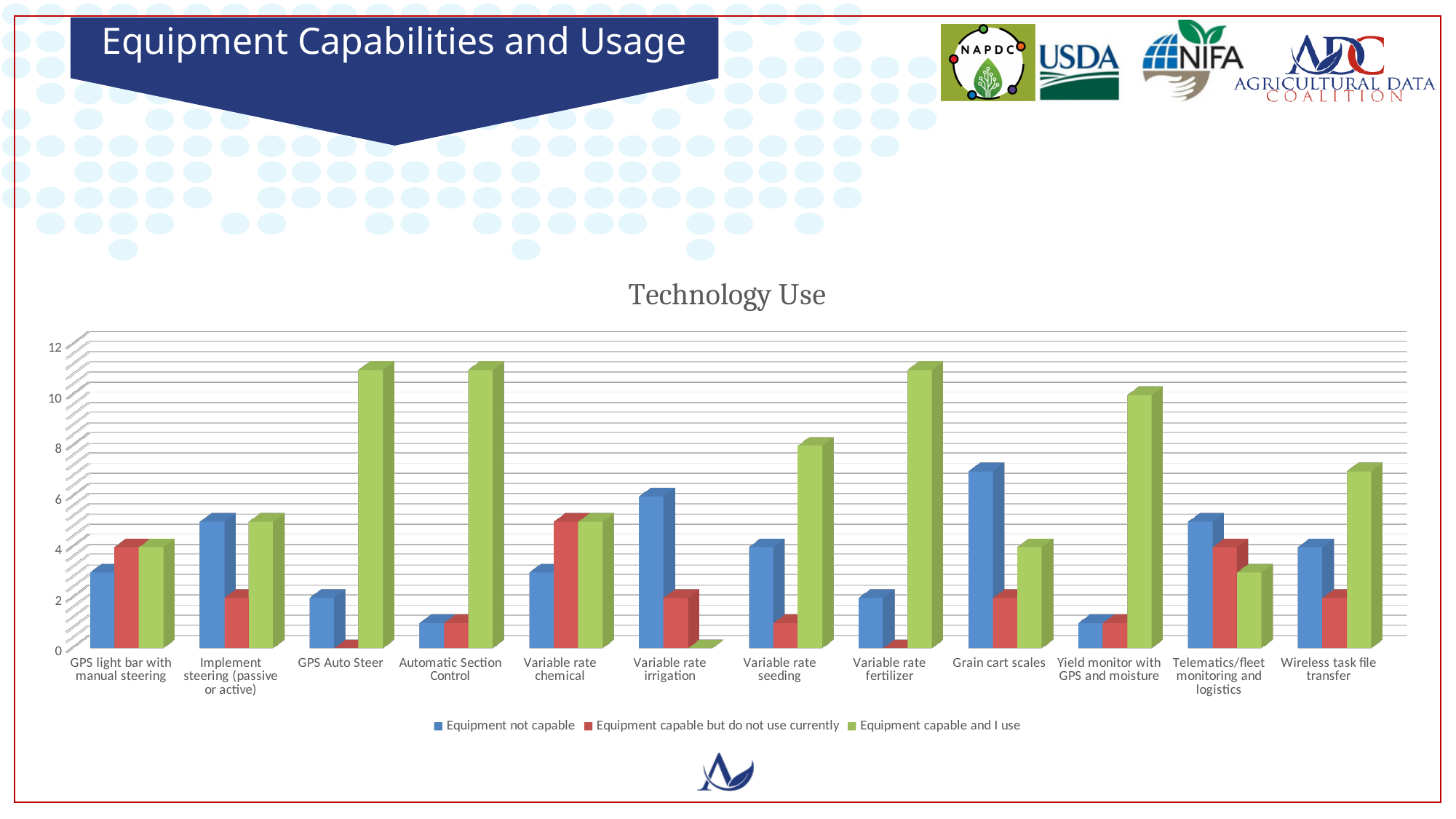
Which colour represents the series "Equipment capable and I use"? green For Wireless task file transfer, which is larger: "Equipment not capable" or "Equipment capable and I use"? Equipment capable and I use Which category has the lowest value for "Equipment capable and I use"? Variable rate irrigation Which category has the highest value for "Equipment not capable"? Grain cart scales For Variable rate chemical, which is larger: "Equipment not capable" or "Equipment capable but do not use currently"? Equipment capable but do not use currently How many series does the legend list? 3 What kind of chart is shown on the slide? bar chart Is the value for "Equipment not capable" for Variable rate irrigation greater or less than 4? greater How many technology categories are shown along the x axis? 12 What is the title of the chart? Technology Use Which category has the highest value for "Equipment capable but do not use currently"? Variable rate chemical Is the value for "Equipment capable and I use" for GPS Auto Steer greater or less than 10? greater